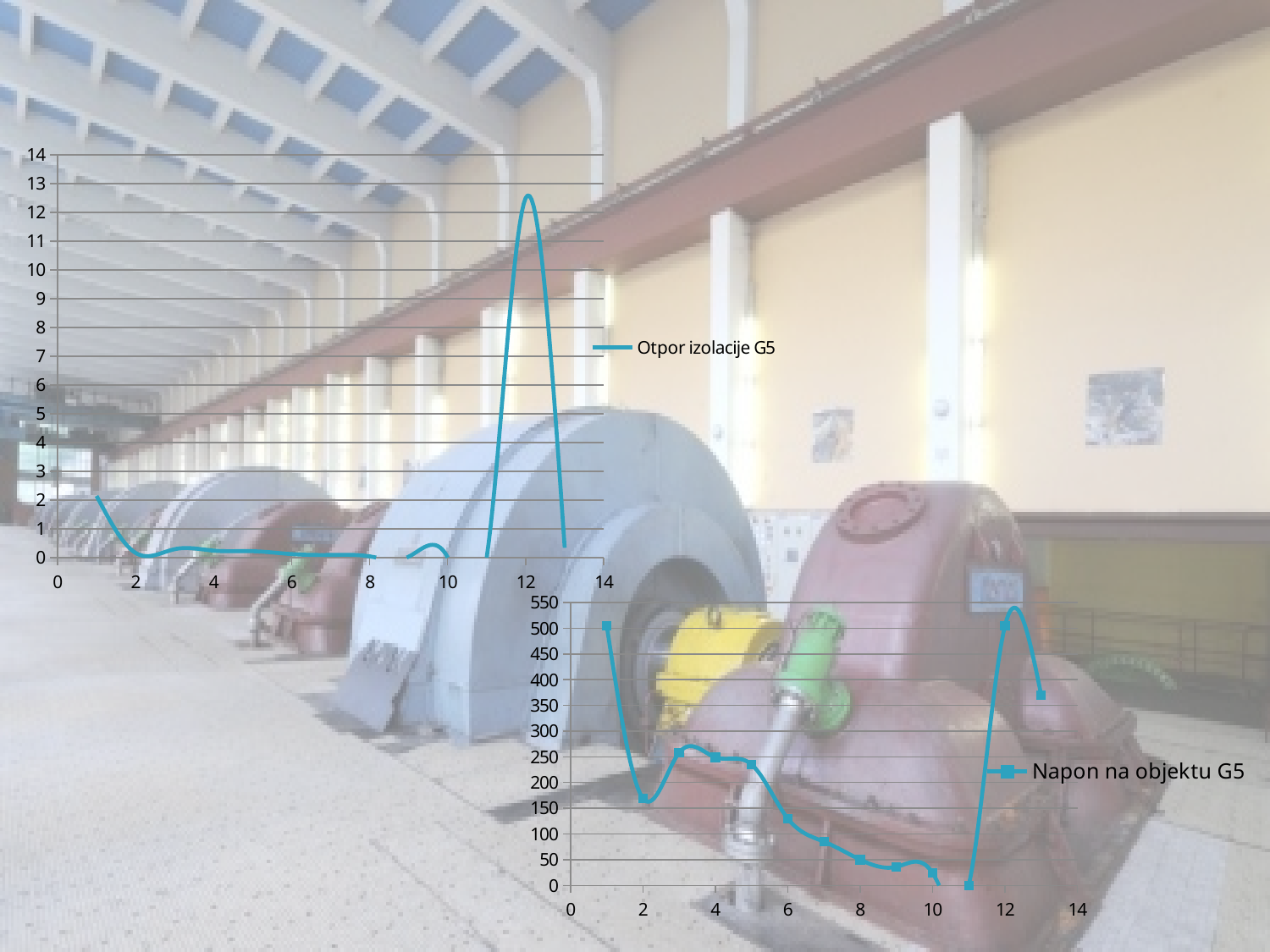
How many series does the legend of the top-left chart 'Otpor izolacije G5' list? 1 In the top-left chart 'Otpor izolacije G5', is the value at x = 1 greater or less than 3? less In the bottom-right chart 'Napon na objektu G5', at which x value is the lowest point? 11 In the bottom-right chart 'Napon na objektu G5', which is larger: the value at x = 3 or the value at x = 6? x = 3 What kind of chart is the bottom-right chart titled 'Napon na objektu G5'? line chart In the bottom-right chart 'Napon na objektu G5', is the value at x = 1 greater or less than 450? greater In the top-left chart 'Otpor izolacije G5', is the value at x = 12 greater or less than 10? greater In the top-left chart 'Otpor izolacije G5', at which x value does the line reach its highest point? 12 In the bottom-right chart 'Napon na objektu G5', do the values rise or fall from x = 6 to x = 11? fall What is the legend entry shown on the bottom-right chart? Napon na objektu G5 What kind of chart is the top-left chart titled 'Otpor izolacije G5'? line chart